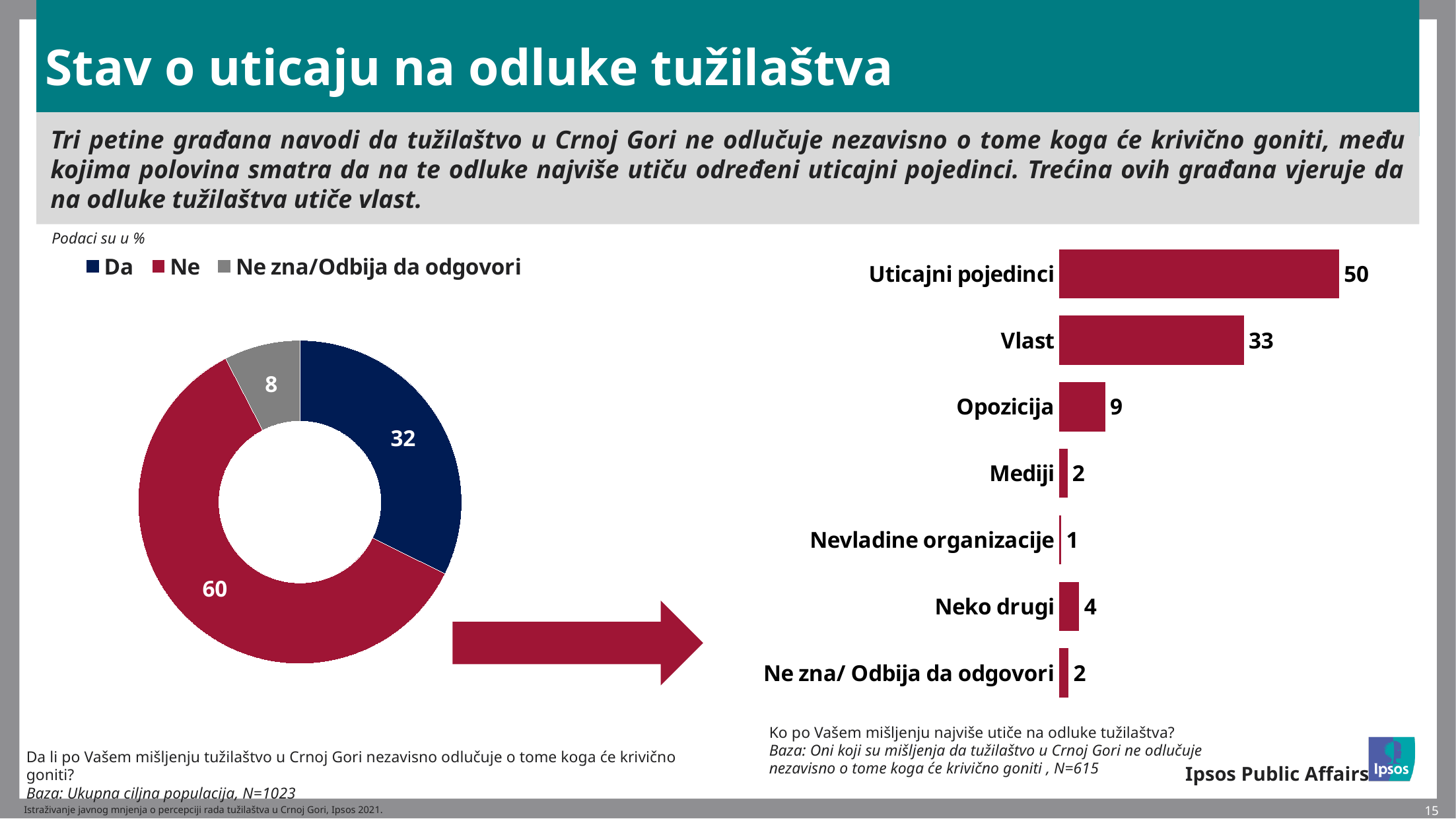
In the donut chart on the left, which category has the smallest value? Ne zna/Odbija da odgovori In the donut chart on the left, how many entries does the legend list? 3 In the bar chart on the right, what is the value for "Opozicija"? 9 In the donut chart on the left, what is the difference between the values for "Ne" and "Da"? 28 In the bar chart on the right, which category has the lowest value? Nevladine organizacije In the donut chart on the left, what is the value for "Ne"? 60 In the bar chart on the right, how many categories are shown? 7 In the bar chart on the right, what is the difference between the values for "Uticajni pojedinci" and "Vlast"? 17 In the bar chart on the right, what is the value for "Vlast"? 33 What kind of chart is shown on the right side of the slide? Bar chart In the donut chart on the left, what is the value for "Da"? 32 In the bar chart on the right, which category has the highest value? Uticajni pojedinci